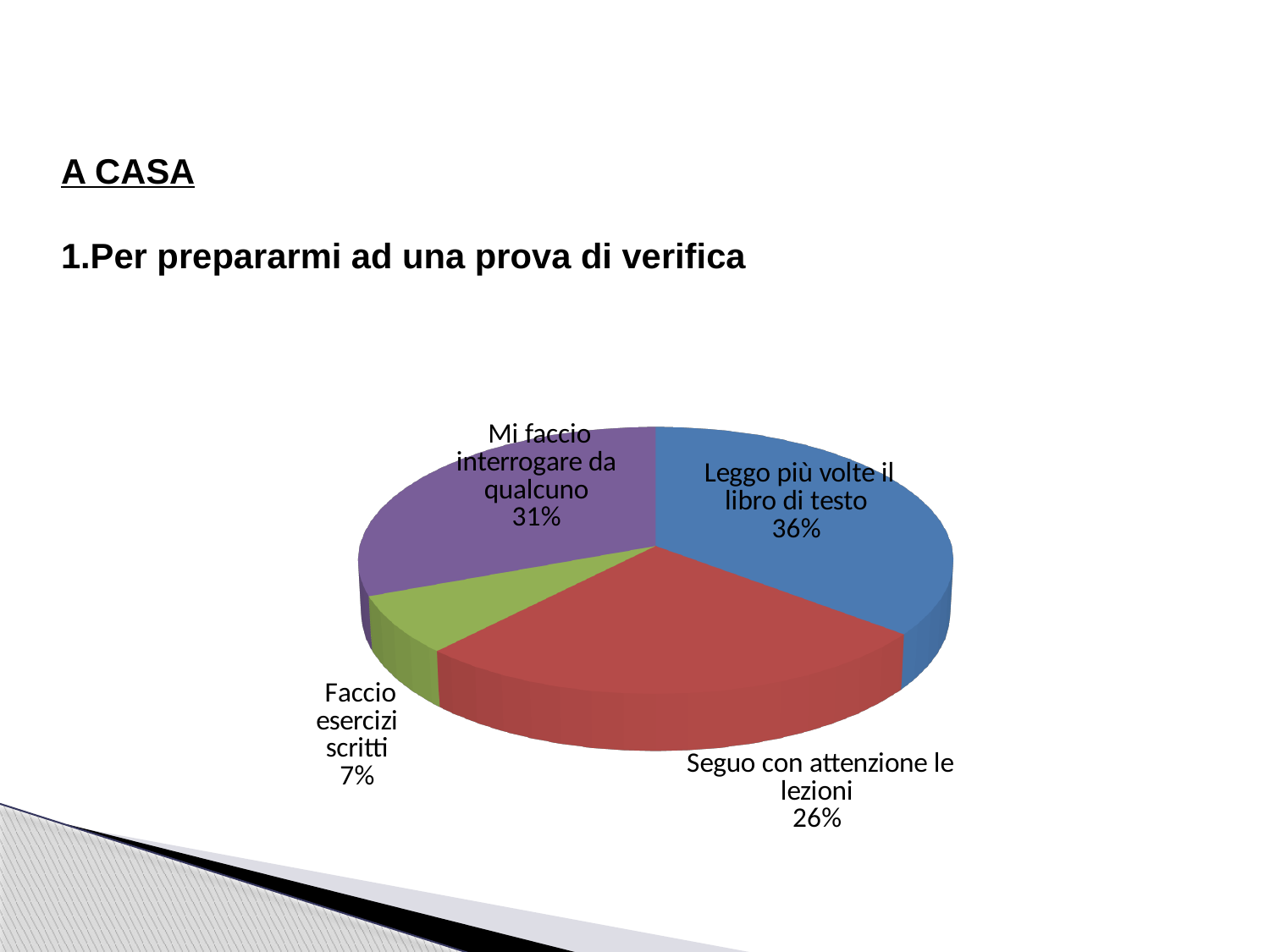
What percentage of the pie is 'Faccio esercizi scritti'? 7% What colour is the slice for 'Faccio esercizi scritti'? Green What kind of chart is shown on the slide? Pie chart Which is larger: 'Mi faccio interrogare da qualcuno' or 'Seguo con attenzione le lezioni'? Mi faccio interrogare da qualcuno What percentage of the pie is 'Seguo con attenzione le lezioni'? 26% What percentage of the pie is 'Leggo più volte il libro di testo'? 36% What percentage of the pie is 'Mi faccio interrogare da qualcuno'? 31% What is the difference in percentage points between 'Leggo più volte il libro di testo' and 'Seguo con attenzione le lezioni'? 10 What is the difference in percentage points between 'Mi faccio interrogare da qualcuno' and 'Faccio esercizi scritti'? 24 Which category has the smallest share of the pie? Faccio esercizi scritti Which category has the largest share of the pie? Leggo più volte il libro di testo How many categories are shown in the pie chart? 4